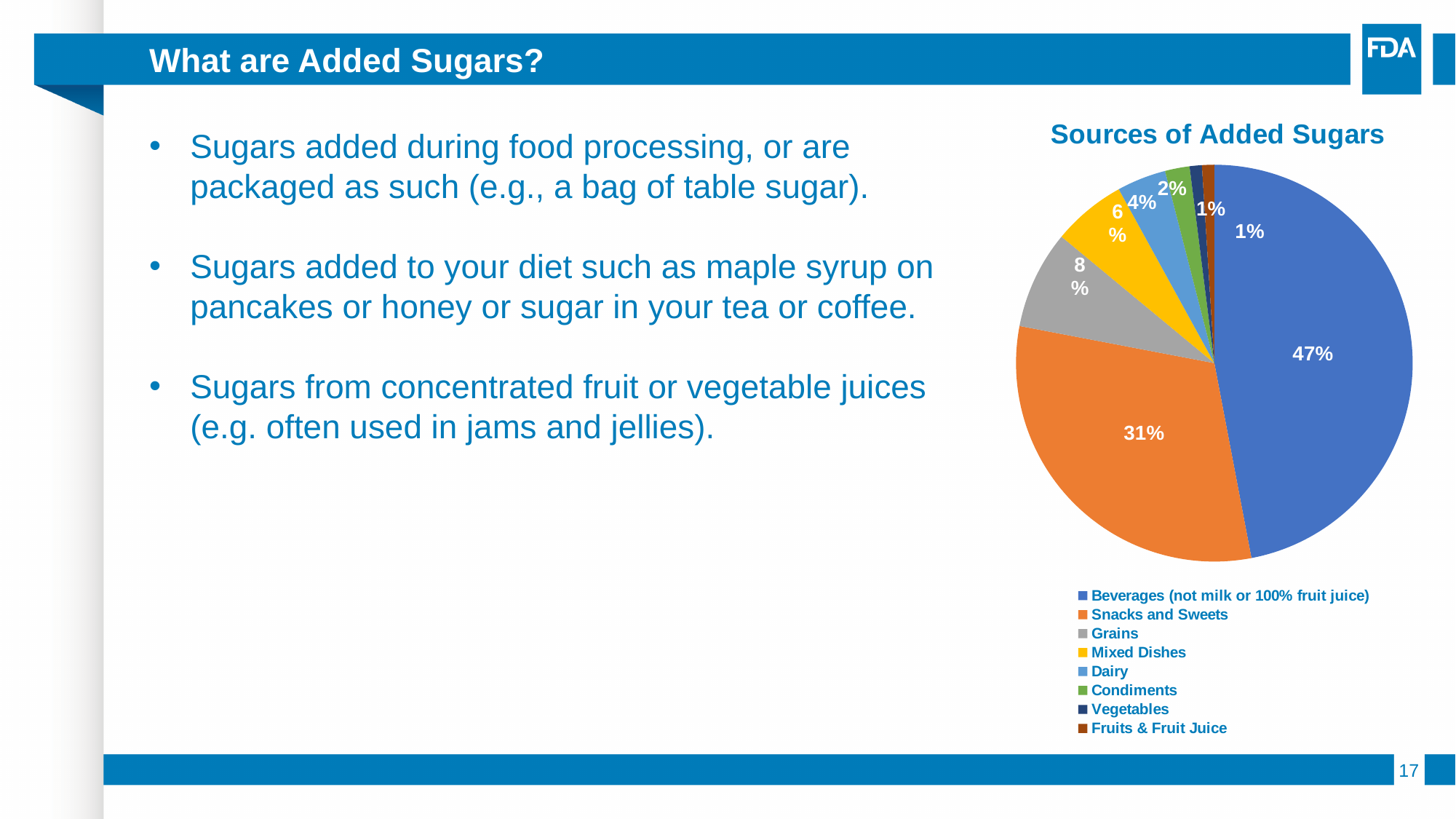
What colour is the Snacks and Sweets slice in the pie chart? orange What kind of chart is shown on the slide? pie chart What share of added sugars comes from Beverages (not milk or 100% fruit juice)? 47% What share of added sugars comes from Mixed Dishes? 6% Which source accounts for the largest share of added sugars? Beverages (not milk or 100% fruit juice) Which contributes a larger share of added sugars, Grains or Dairy? Grains What is the difference in percentage points between the Beverages share and the Snacks and Sweets share? 16 What share of added sugars comes from Grains? 8% How many sources of added sugars are listed in the chart legend? 8 What share of added sugars comes from Snacks and Sweets? 31% What share of added sugars comes from Dairy? 4% What is the title of the chart on the slide? Sources of Added Sugars